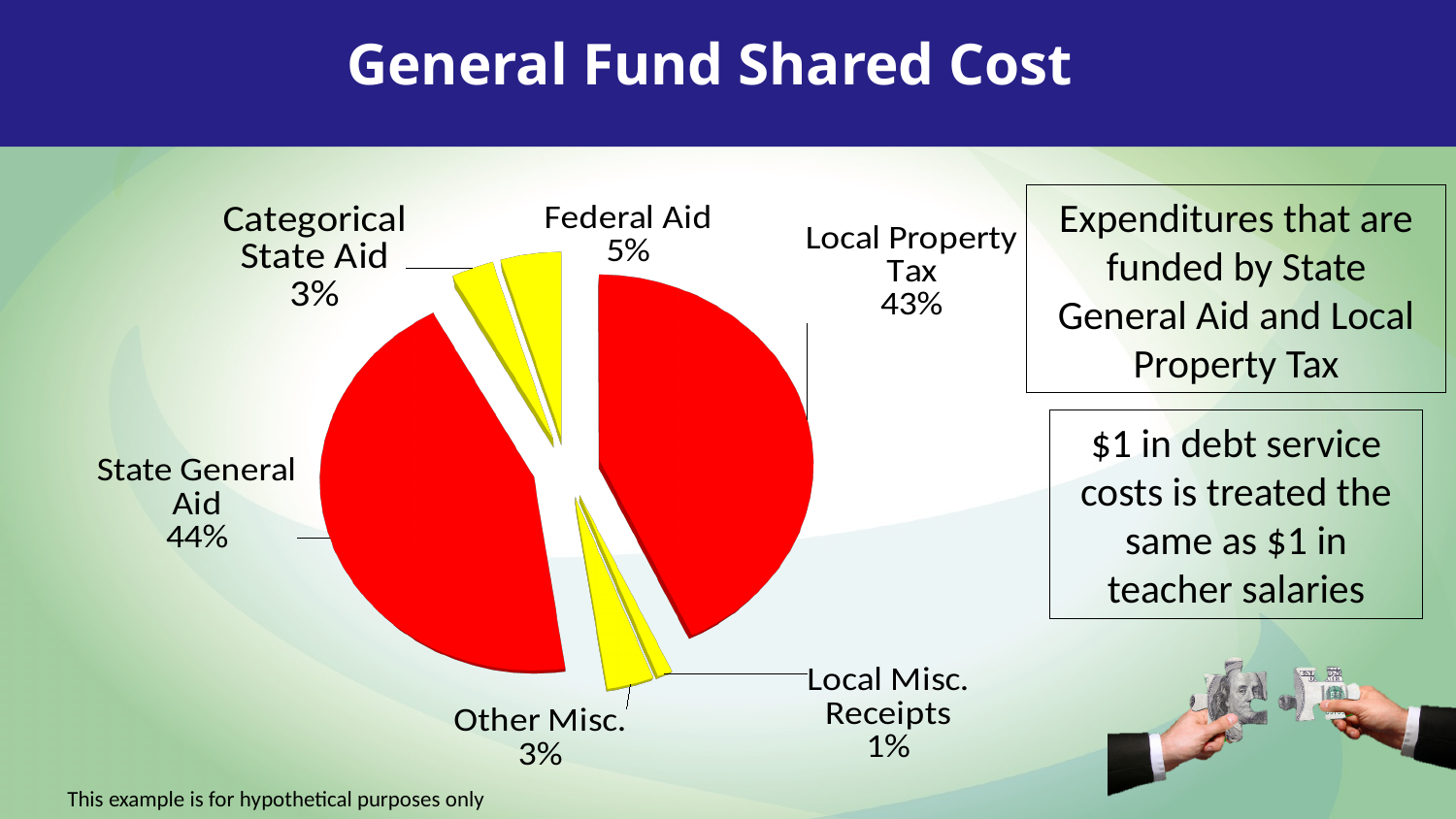
Which slice of the pie is the smallest? Local Misc. Receipts What share of the pie is State General Aid? 44% What is the difference between the State General Aid share and the Federal Aid share? 39% How many slices does the pie chart have? 6 What share of the pie is Categorical State Aid? 3% Which slice of the pie is the largest? State General Aid What kind of chart is shown on the slide? pie chart What share of the pie is Federal Aid? 5% What share of the pie is Local Property Tax? 43% What is the title of the chart on the slide? General Fund Shared Cost What share of the pie is Local Misc. Receipts? 1% Which is larger, the Federal Aid share or the Other Misc. share? Federal Aid